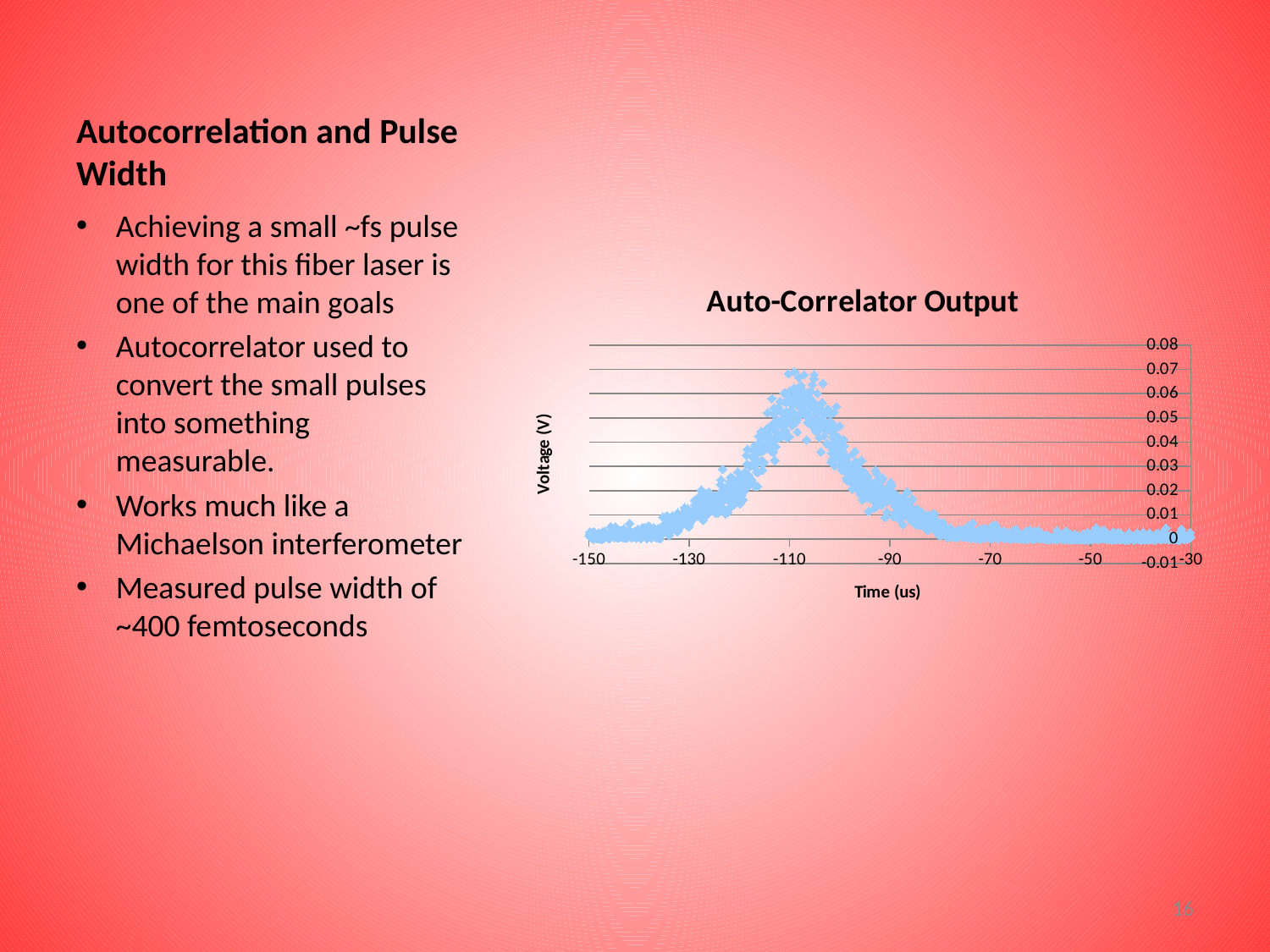
On the Auto-Correlator Output chart, does the voltage rise or fall as time goes from -130 to -110? rise Is the peak voltage on the Auto-Correlator Output chart greater or less than 0.08? less What is the highest tick value shown on the y axis of the Auto-Correlator Output chart? 0.08 Is the voltage at time -150 on the Auto-Correlator Output chart greater or less than 0.02? less Is the voltage at time -110 on the Auto-Correlator Output chart greater or less than 0.04? greater What kind of chart is the Auto-Correlator Output chart? scatter chart On the Auto-Correlator Output chart, is the voltage at time -110 larger or smaller than the voltage at time -70? larger What is the title of the chart on the slide? Auto-Correlator Output On the Auto-Correlator Output chart, does the voltage rise or fall as time goes from -110 to -90? fall What is the label of the x axis on the Auto-Correlator Output chart? Time (us)